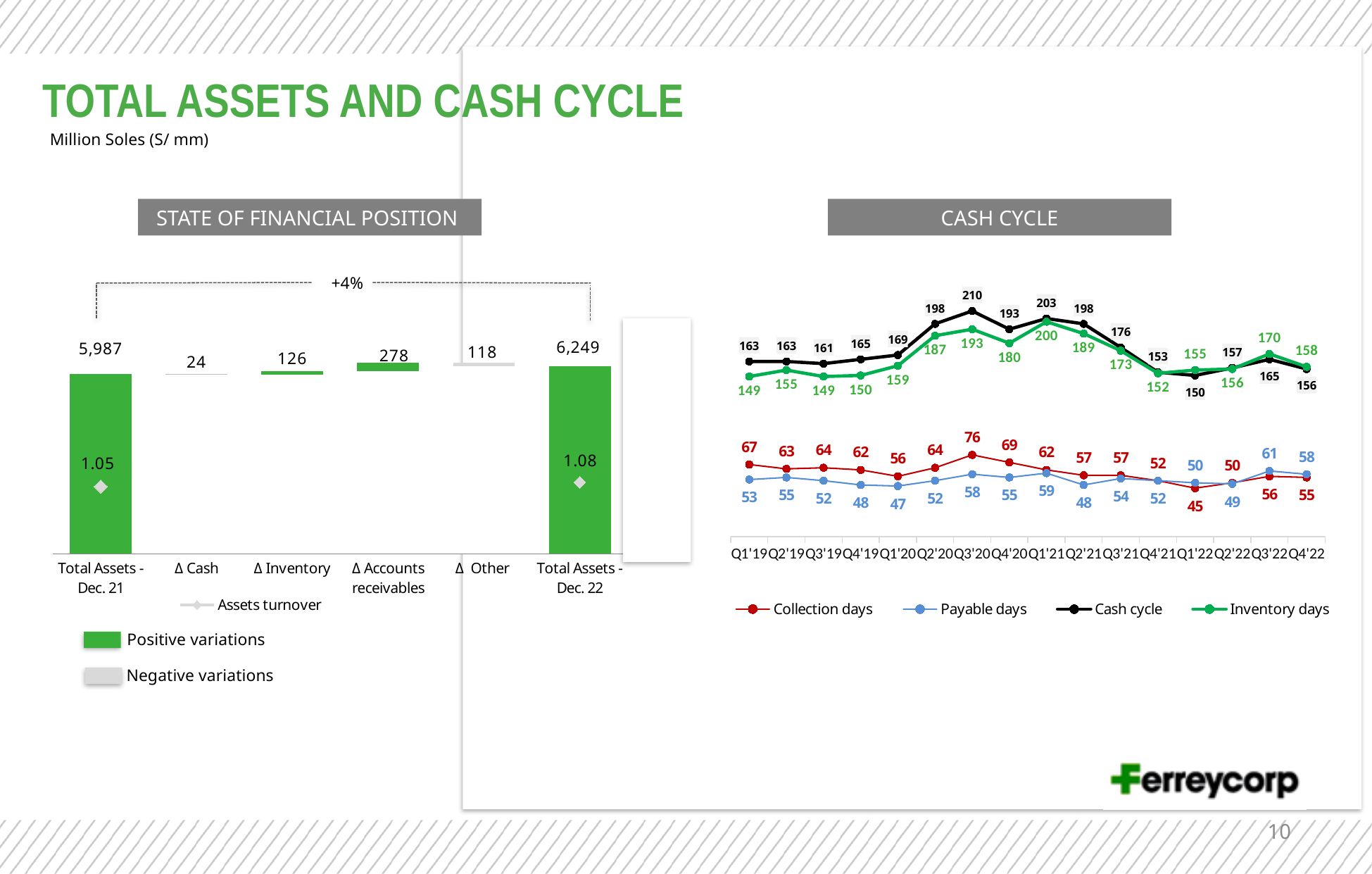
In the State of Financial Position chart, what is the Assets turnover value shown for Dec. 22? 1.08 In the State of Financial Position chart, what is the value of Total Assets - Dec. 21? 5,987 In the State of Financial Position chart, what is the value of Total Assets - Dec. 22? 6,249 In the Cash Cycle chart, in which quarter are Collection days highest? Q3'20 In the Cash Cycle chart, in which quarter are Collection days lowest? Q1'22 In the State of Financial Position chart, what is the difference between Total Assets - Dec. 22 and Total Assets - Dec. 21? 262 In the State of Financial Position chart, what is the value shown for Δ Accounts receivables? 278 In the Cash Cycle chart, what is the difference between Collection days and Payable days in Q4'22? 3 In the State of Financial Position chart, what percentage change is shown between Total Assets - Dec. 21 and Total Assets - Dec. 22? +4% In the Cash Cycle chart, what is the Inventory days value for Q1'21? 200 In the Cash Cycle chart, what is the Cash cycle value for Q3'20? 210 How many series does the legend of the Cash Cycle chart list? 4